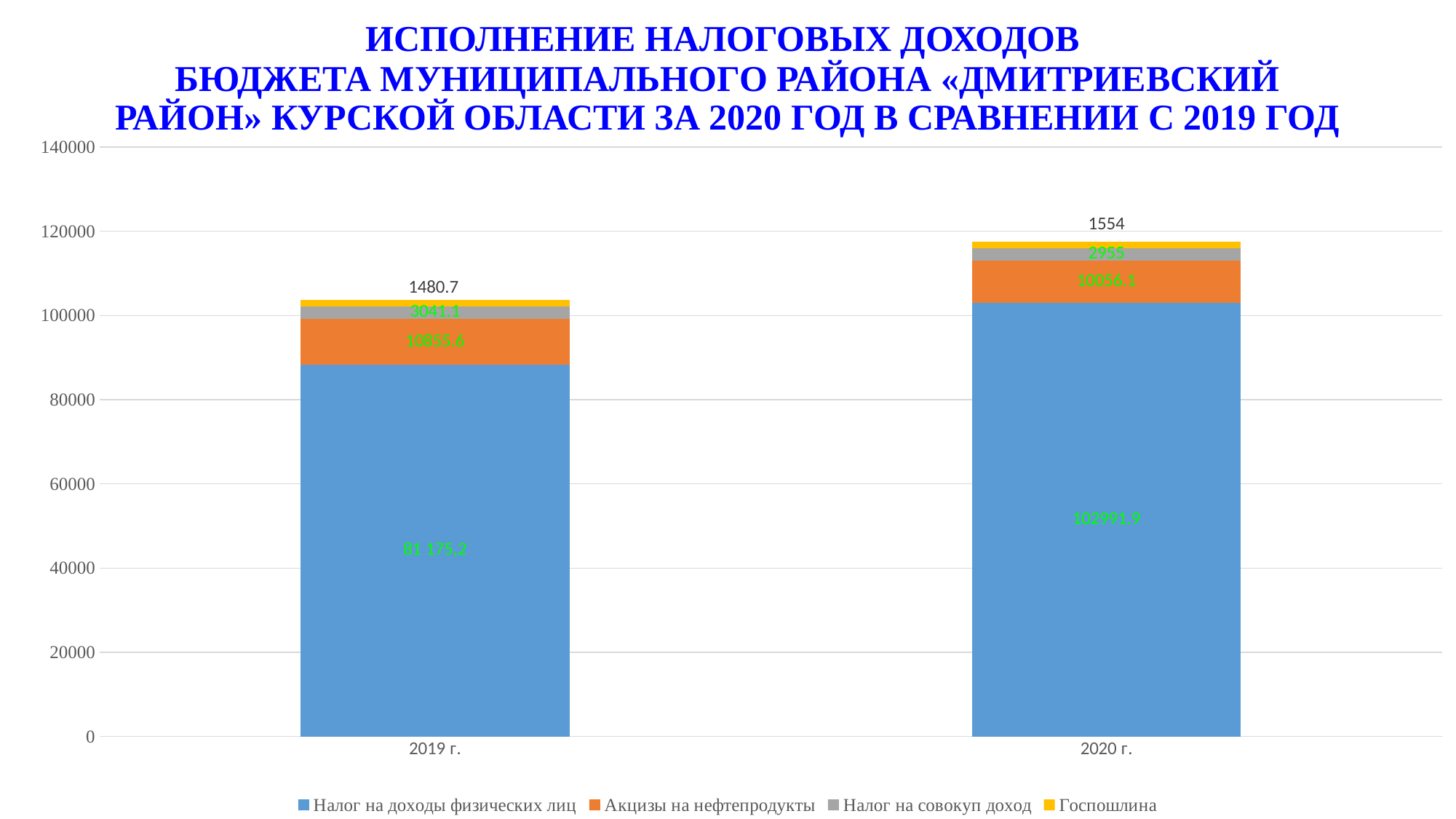
What is the value of Акцизы на нефтепродукты for 2019 г.? 10855.6 What is the value of Налог на доходы физических лиц for 2020 г.? 102991.9 How many series does the legend list? 4 What is the difference between the Госпошлина values for 2020 г. and 2019 г.? 73.3 How many categories (years) are shown on the x axis? 2 Which year has the larger value for Акцизы на нефтепродукты, 2019 г. or 2020 г.? 2019 г. Which series is shown in yellow in the legend? Госпошлина What is the total of the stacked bar for 2020 г.? 117557 Is the total height of the 2019 г. stacked bar greater or less than 100000? greater What is the value of Госпошлина for 2020 г.? 1554 What type of chart is shown on the slide? Stacked bar chart What is the value of Налог на совокуп доход for 2019 г.? 3041.1